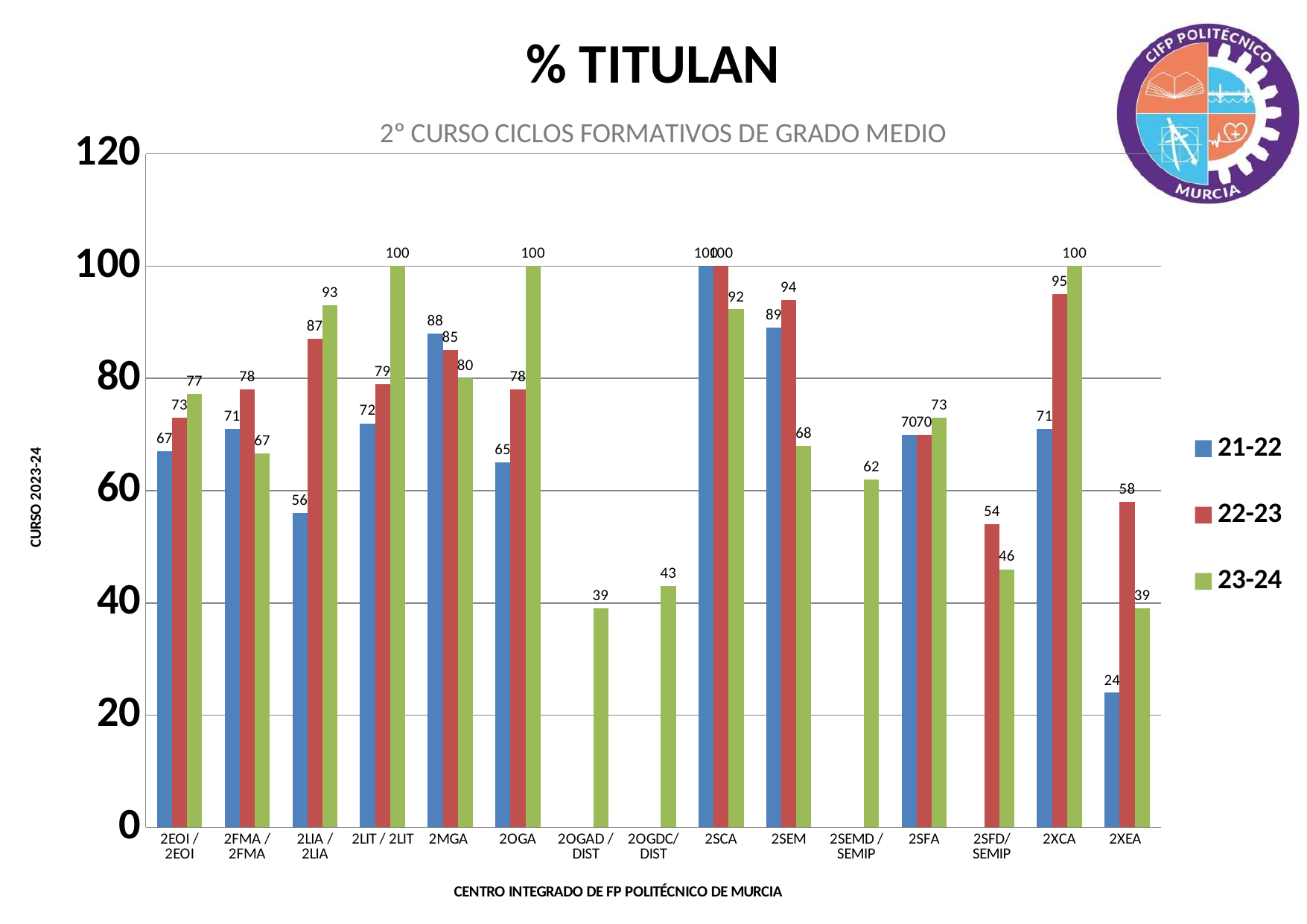
Which is larger for 2MGA, the 21-22 value or the 23-24 value? 21-22 What is the 22-23 value for 2XCA? 95 How many series does the legend list? 3 What kind of chart is shown? bar chart What is the subtitle of the chart? 2º CURSO CICLOS FORMATIVOS DE GRADO MEDIO What is the 23-24 value for 2OGAD / DIST? 39 Which category has the lowest 21-22 value? 2XEA What is the 23-24 value for 2LIA / 2LIA? 93 What is the 21-22 value for 2XEA? 24 How many categories are shown on the x axis? 15 Which category has the highest 22-23 value? 2SCA What is the difference between the 22-23 and 21-22 values for 2LIA / 2LIA? 31